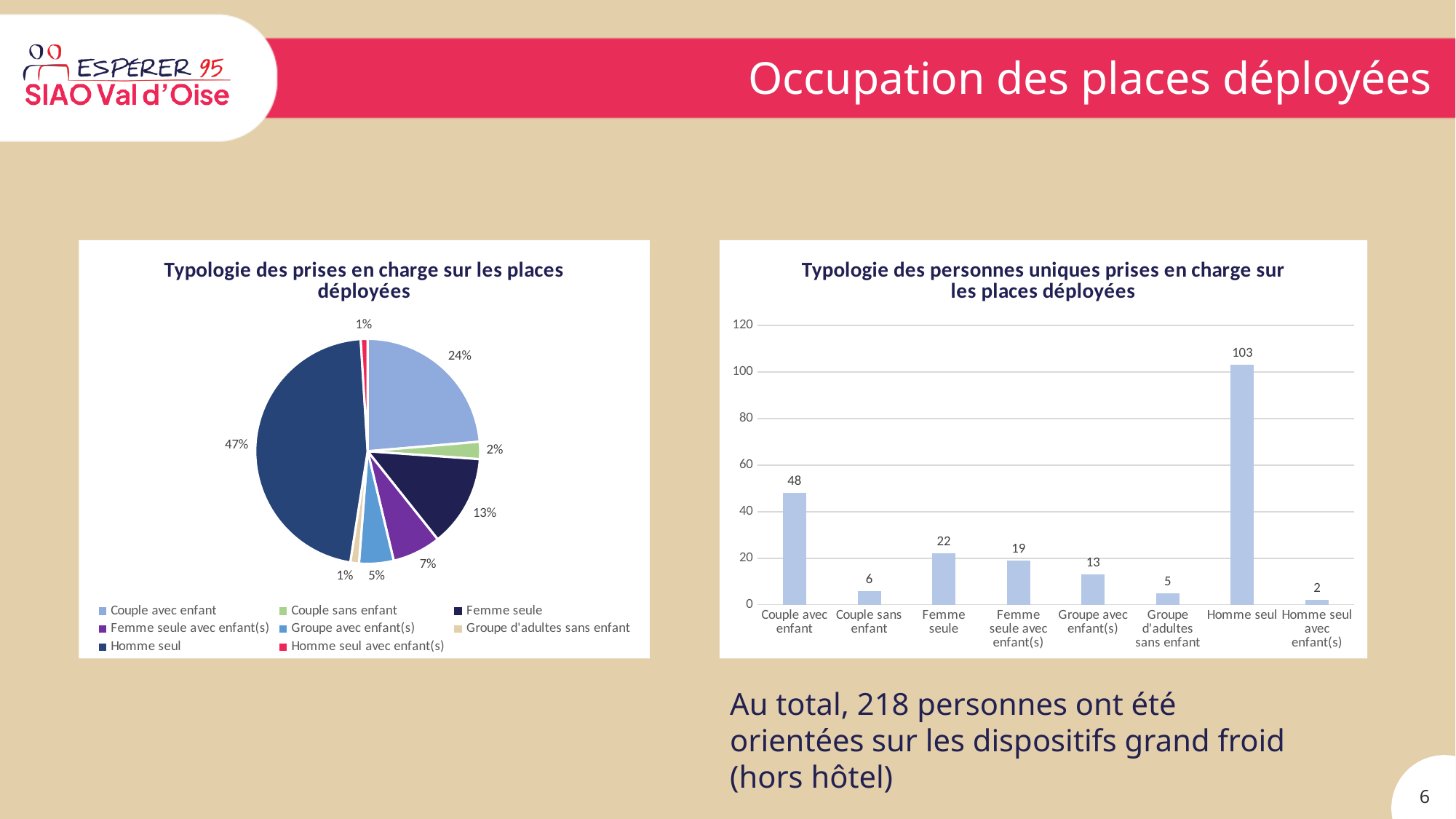
In the pie chart 'Typologie des prises en charge sur les places déployées', how many categories does the legend list? 8 What kind of chart is the one on the right of the slide? Bar chart In the bar chart 'Typologie des personnes uniques prises en charge sur les places déployées', which category has the lowest value? Homme seul avec enfant(s) In the bar chart 'Typologie des personnes uniques prises en charge sur les places déployées', what is the value for 'Femme seule avec enfant(s)'? 19 In the bar chart 'Typologie des personnes uniques prises en charge sur les places déployées', how many categories are shown on the x axis? 8 In the pie chart 'Typologie des prises en charge sur les places déployées', which is larger: 'Femme seule' or 'Femme seule avec enfant(s)'? Femme seule In the bar chart 'Typologie des personnes uniques prises en charge sur les places déployées', what is the difference between 'Couple avec enfant' and 'Femme seule'? 26 In the pie chart 'Typologie des prises en charge sur les places déployées', what share does 'Couple avec enfant' represent? 24% In the pie chart 'Typologie des prises en charge sur les places déployées', what share does 'Homme seul' represent? 47% In the bar chart 'Typologie des personnes uniques prises en charge sur les places déployées', what is the value for 'Homme seul'? 103 What kind of chart is the one on the left of the slide? Pie chart In the pie chart 'Typologie des prises en charge sur les places déployées', which category has the largest share? Homme seul